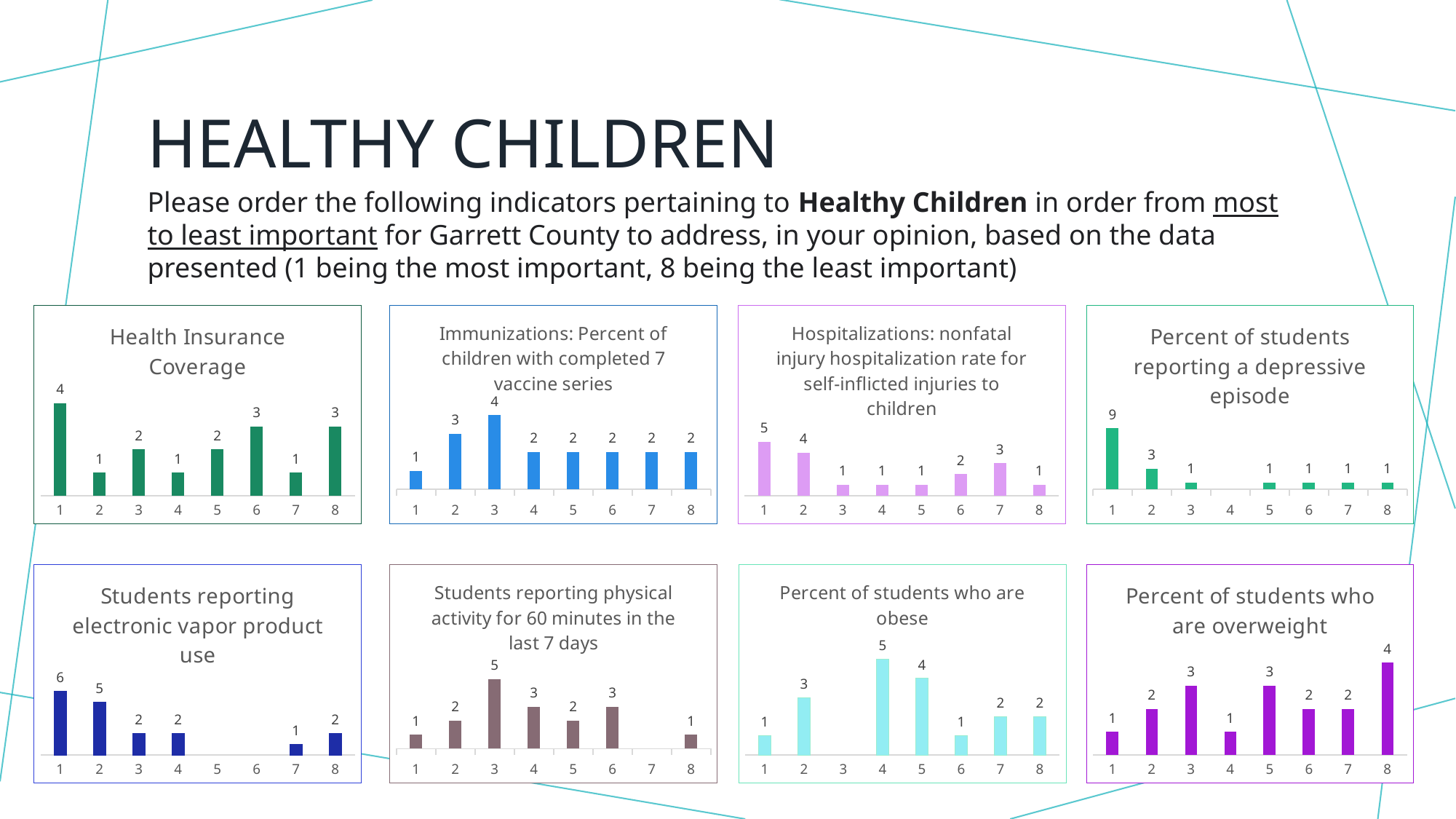
In the "Immunizations: Percent of children with completed 7 vaccine series" chart, which category has the highest value? 3 In the "Students reporting electronic vapor product use" chart, which is larger, the value for category 1 or category 2? Category 1 In the "Percent of students reporting a depressive episode" chart, which category has the highest value? 1 In the "Percent of students who are overweight" chart, what is the value for category 8? 4 How many charts are shown on the slide? 8 In the "Percent of students who are obese" chart, which category has the highest value? 4 In the "Health Insurance Coverage" chart, what is the value for category 1? 4 What kind of chart is the "Health Insurance Coverage" chart? Bar chart How many categories are shown on the x axis of the "Percent of students who are overweight" chart? 8 In the "Students reporting physical activity for 60 minutes in the last 7 days" chart, what is the value for category 3? 5 In the "Percent of students reporting a depressive episode" chart, what is the value for category 1? 9 In the "Hospitalizations: nonfatal injury hospitalization rate for self-inflicted injuries to children" chart, what is the difference between the values for category 1 and category 7? 2